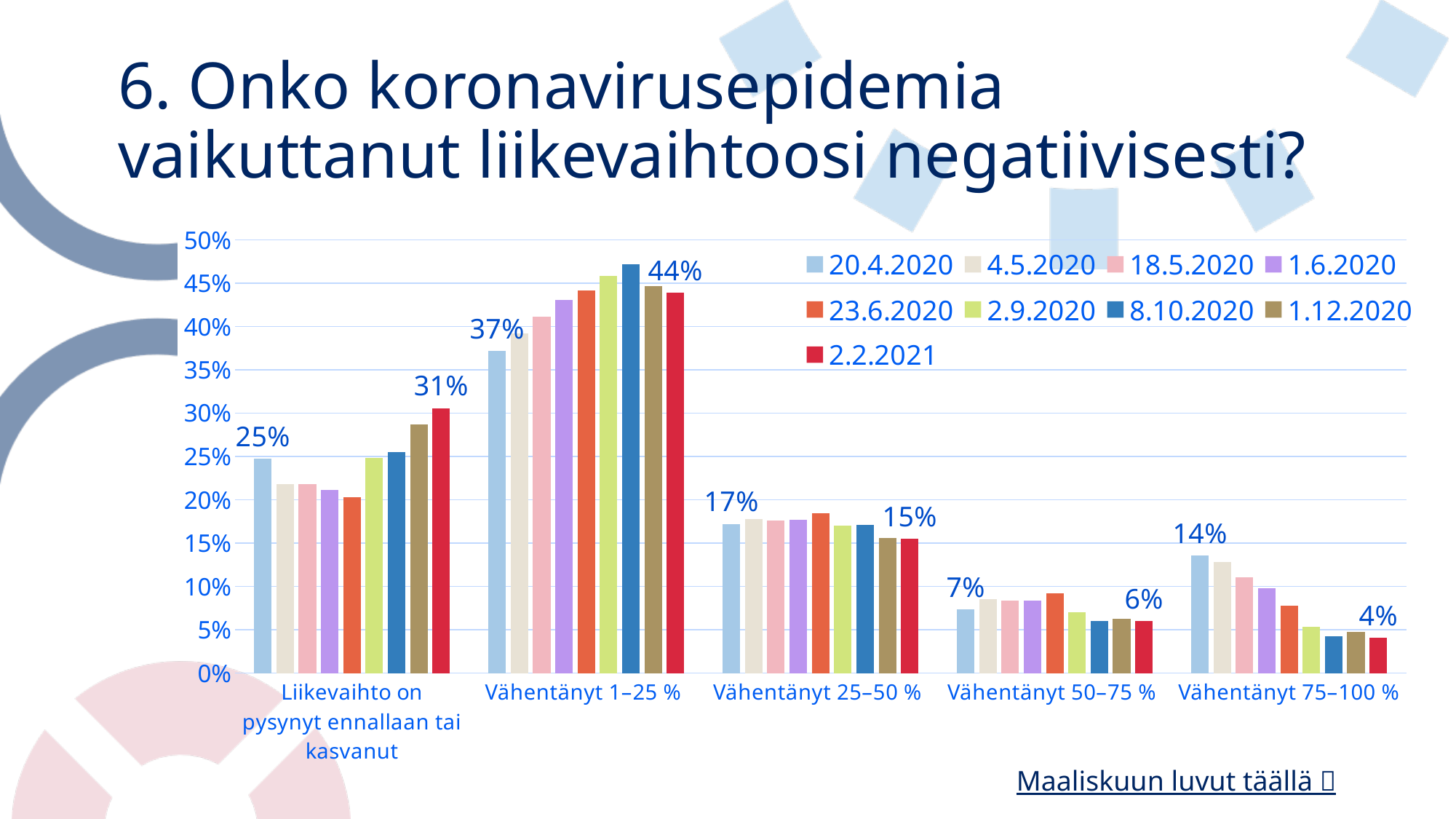
What is the value for 2.2.2021 in the category 'Vähentänyt 1–25 %'? 44% What is the difference between the 20.4.2020 and 2.2.2021 values in the category 'Vähentänyt 75–100 %'? 10% Which category has the lowest value for the 2.2.2021 series? Vähentänyt 75–100 % How many series does the legend list? 9 What is the value for 2.2.2021 in the category 'Liikevaihto on pysynyt ennallaan tai kasvanut'? 31% Is the value for 8.10.2020 in the category 'Vähentänyt 1–25 %' greater or less than 45%? greater Which category has the highest value for the 2.2.2021 series? Vähentänyt 1–25 % What is the value for 20.4.2020 in the category 'Vähentänyt 75–100 %'? 14% What is the value for 20.4.2020 in the category 'Vähentänyt 1–25 %'? 37% How many categories are shown on the x axis? 5 What is the difference between the 2.2.2021 and 20.4.2020 values in the category 'Liikevaihto on pysynyt ennallaan tai kasvanut'? 6% What kind of chart is shown on the slide? bar chart